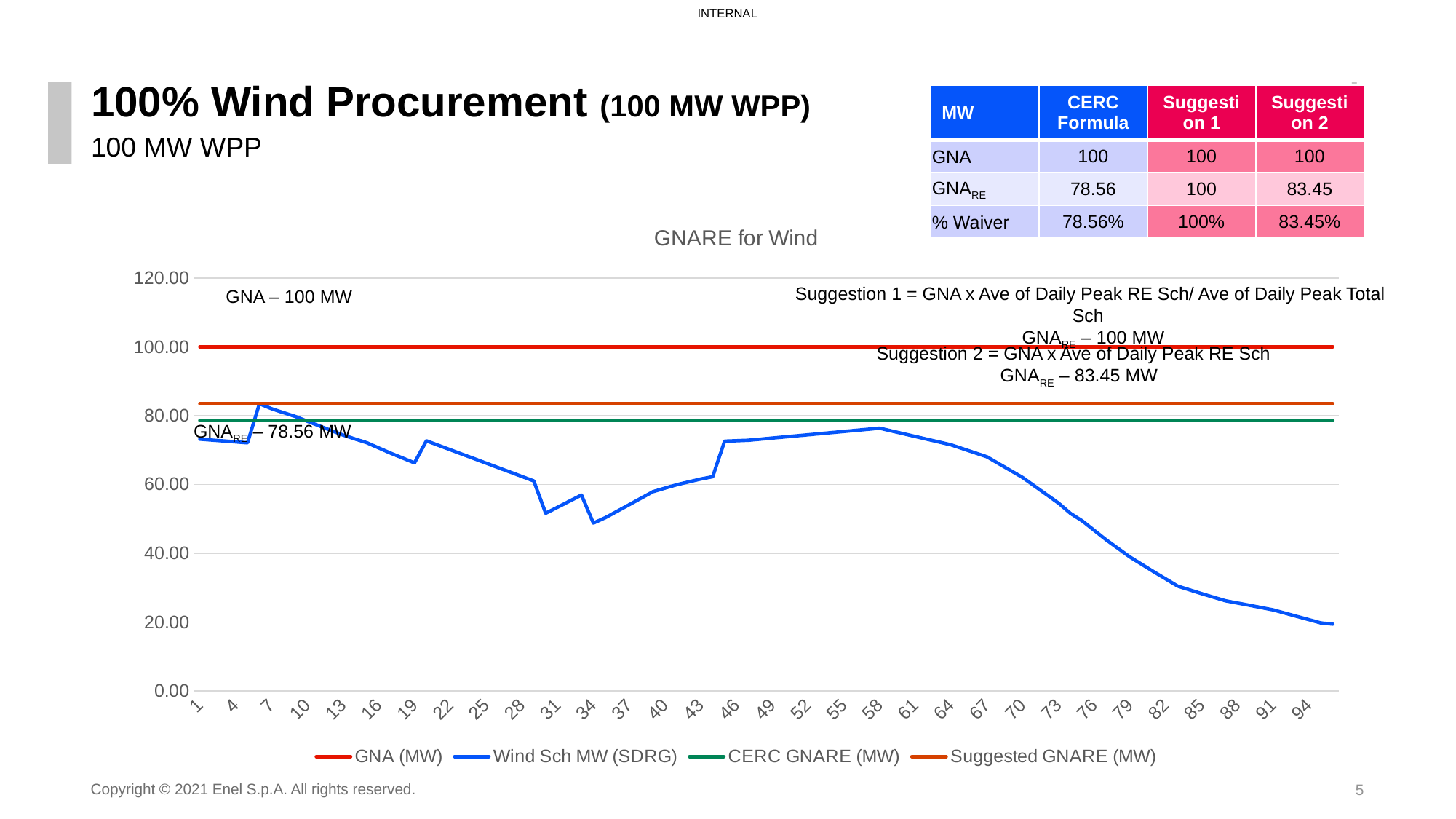
Does the Wind Sch MW (SDRG) line rise or fall between x = 67 and x = 94? fall Is the Wind Sch MW (SDRG) value at x = 94 greater or less than 40? less What value does the Suggested GNARE (MW) line sit at, according to the annotation on the chart? 83.45 MW Is the Wind Sch MW (SDRG) value at x = 58 greater or less than 60? greater Which of the horizontal lines on the chart is the highest? GNA (MW) Which is higher, the Suggested GNARE (MW) line or the CERC GNARE (MW) line? Suggested GNARE (MW) How many series does the chart legend list? 4 What is the difference between the GNA (MW) line and the CERC GNARE (MW) line? 21.44 MW What is the title of the chart? GNARE for Wind What kind of chart is shown on the slide? line chart What value does the GNA (MW) line sit at, according to the annotation on the chart? 100 MW What value does the CERC GNARE (MW) line sit at, according to the annotation on the chart? 78.56 MW